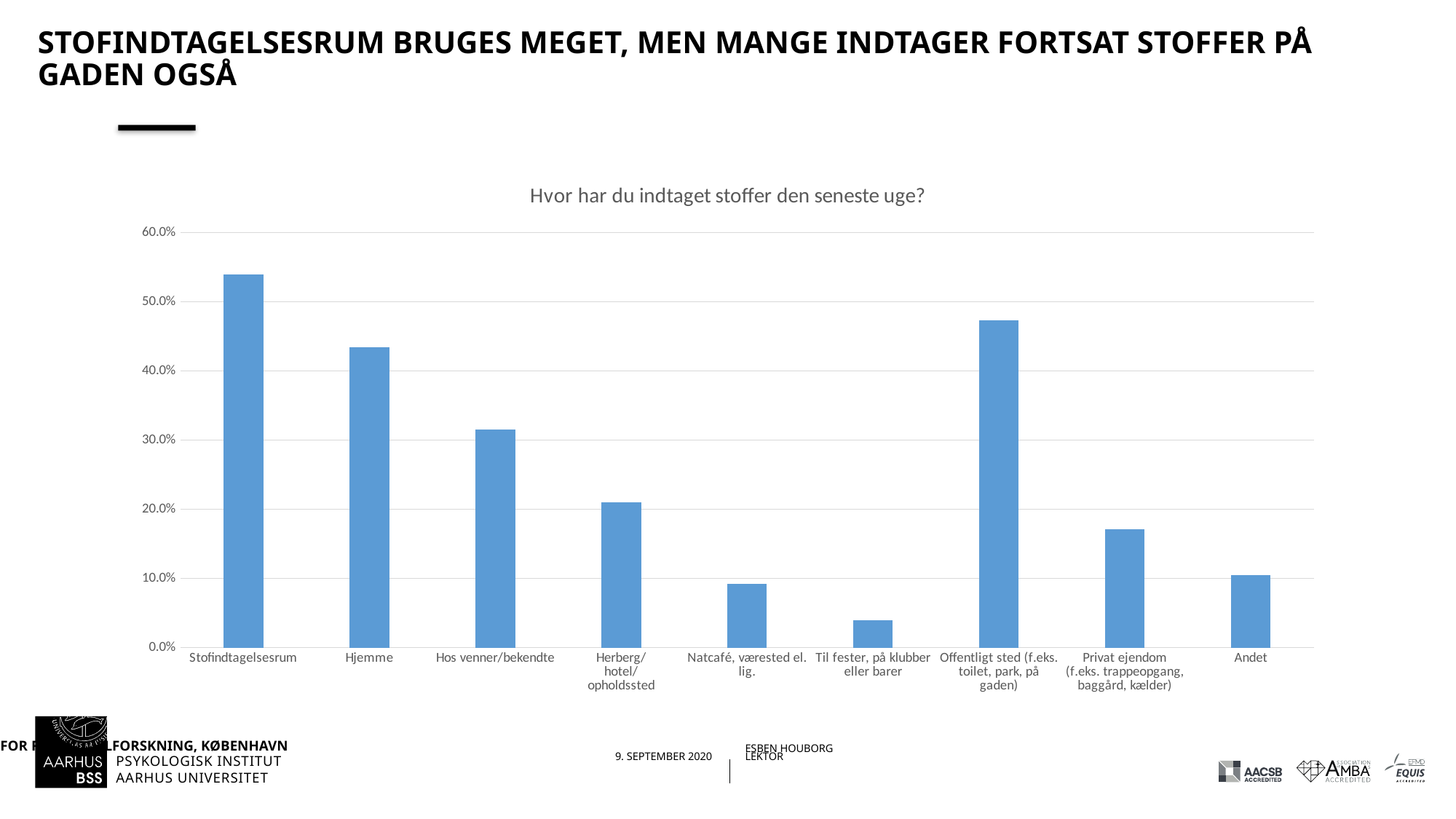
What is the title of the chart? Hvor har du indtaget stoffer den seneste uge? How many categories are shown on the x axis of the chart? 9 What kind of chart is shown on the slide? bar chart Is the value for Herberg/hotel/opholdssted greater or less than 30.0%? less Is the value for Hjemme greater or less than 40.0%? greater Is the value for Stofindtagelsesrum greater or less than 50.0%? greater Which is larger, the value for Privat ejendom (f.eks. trappeopgang, baggård, kælder) or the value for Andet? Privat ejendom (f.eks. trappeopgang, baggård, kælder) Which is larger, the value for Hjemme or the value for Offentligt sted (f.eks. toilet, park, på gaden)? Offentligt sted (f.eks. toilet, park, på gaden) Which category has the lowest value in the chart? Til fester, på klubber eller barer Which category has the highest value in the chart? Stofindtagelsesrum